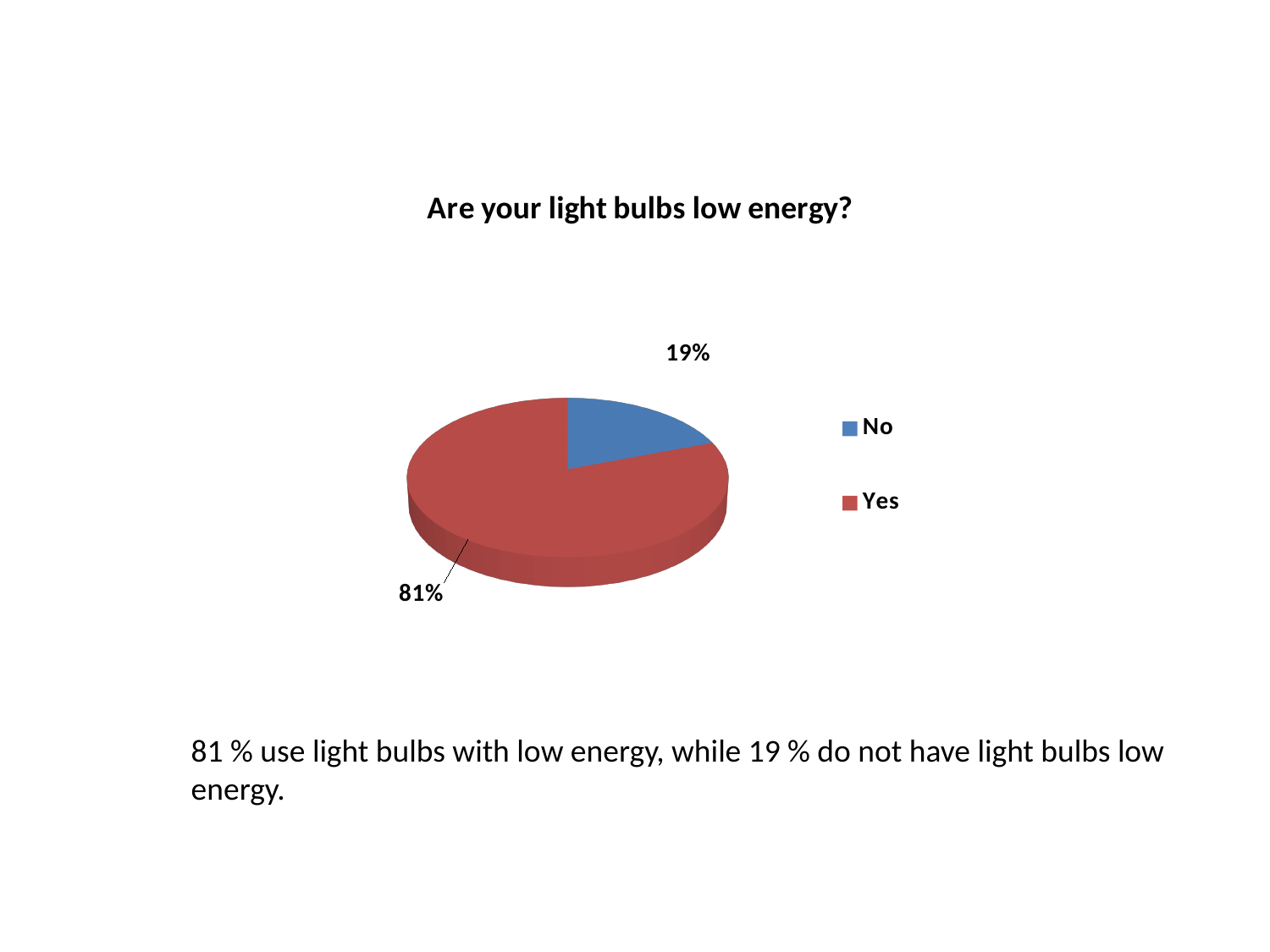
Which category has the largest share of the pie? Yes What colour is the Yes slice? Red What is the title of the chart? Are your light bulbs low energy? How many entries does the legend list? 2 What is the difference in percentage points between the Yes and No slices? 62 What percentage of respondents answered No? 19% Which is larger, the Yes slice or the No slice? Yes What percentage of respondents answered Yes? 81% What share of the pie does the No slice represent? 19% How many categories are shown in the pie chart? 2 What kind of chart is shown on the slide? Pie chart Which category has the smallest share of the pie? No